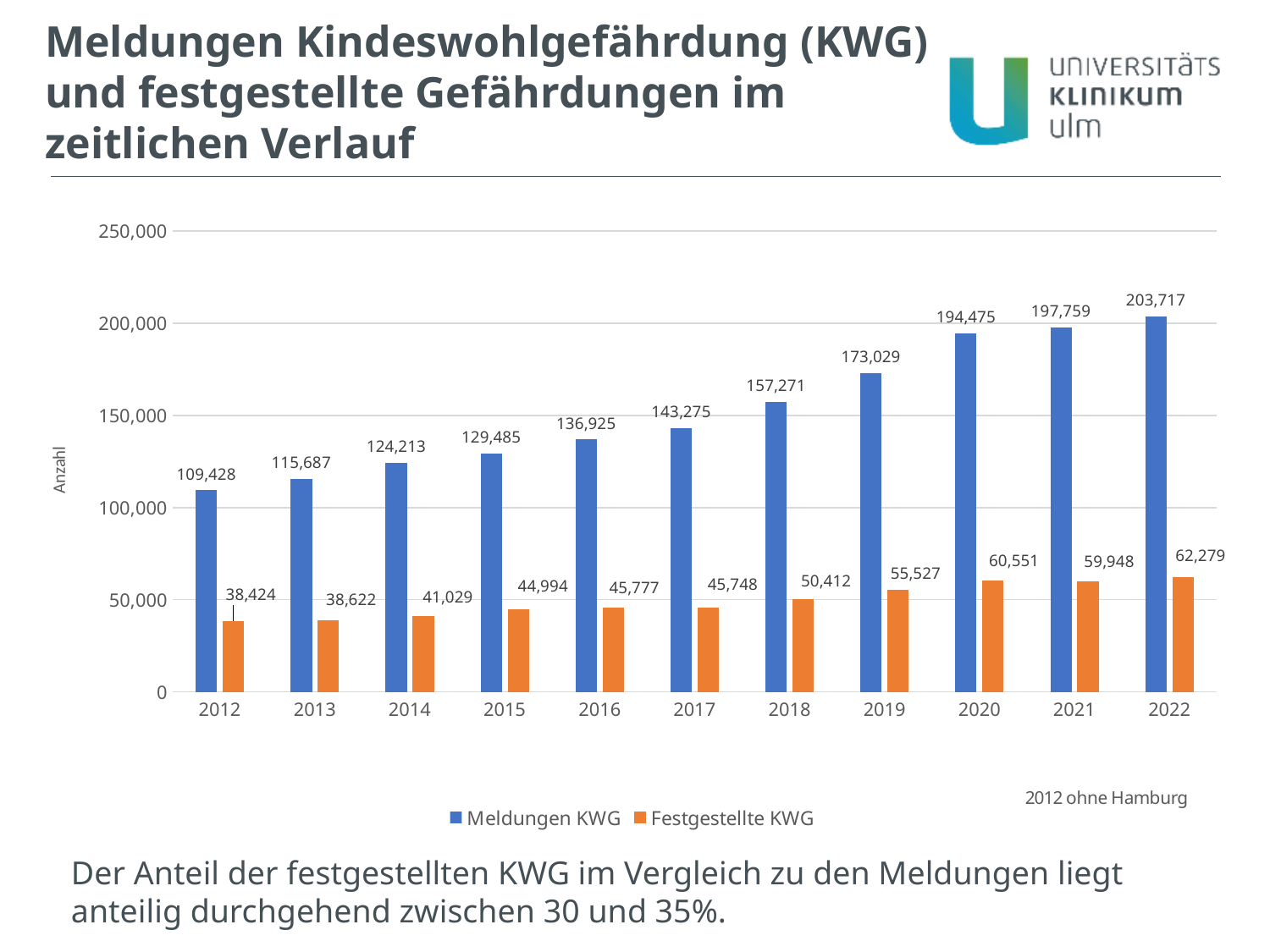
How many years are shown on the x axis? 11 What kind of chart is shown on the slide? bar chart By how much did Meldungen KWG increase from 2012 to 2013? 6,259 Do the Meldungen KWG values rise or fall from 2012 to 2022? rise What is the difference between Meldungen KWG and Festgestellte KWG in 2022? 141,438 Is the value of Meldungen KWG for 2018 greater or less than 150,000? greater How many series does the legend list? 2 In which year is Festgestellte KWG lowest? 2012 In which year is Meldungen KWG highest? 2022 Which year has the larger Festgestellte KWG value, 2020 or 2021? 2020 What is the value of Festgestellte KWG for 2019? 55,527 What is the value of Meldungen KWG for 2016? 136,925